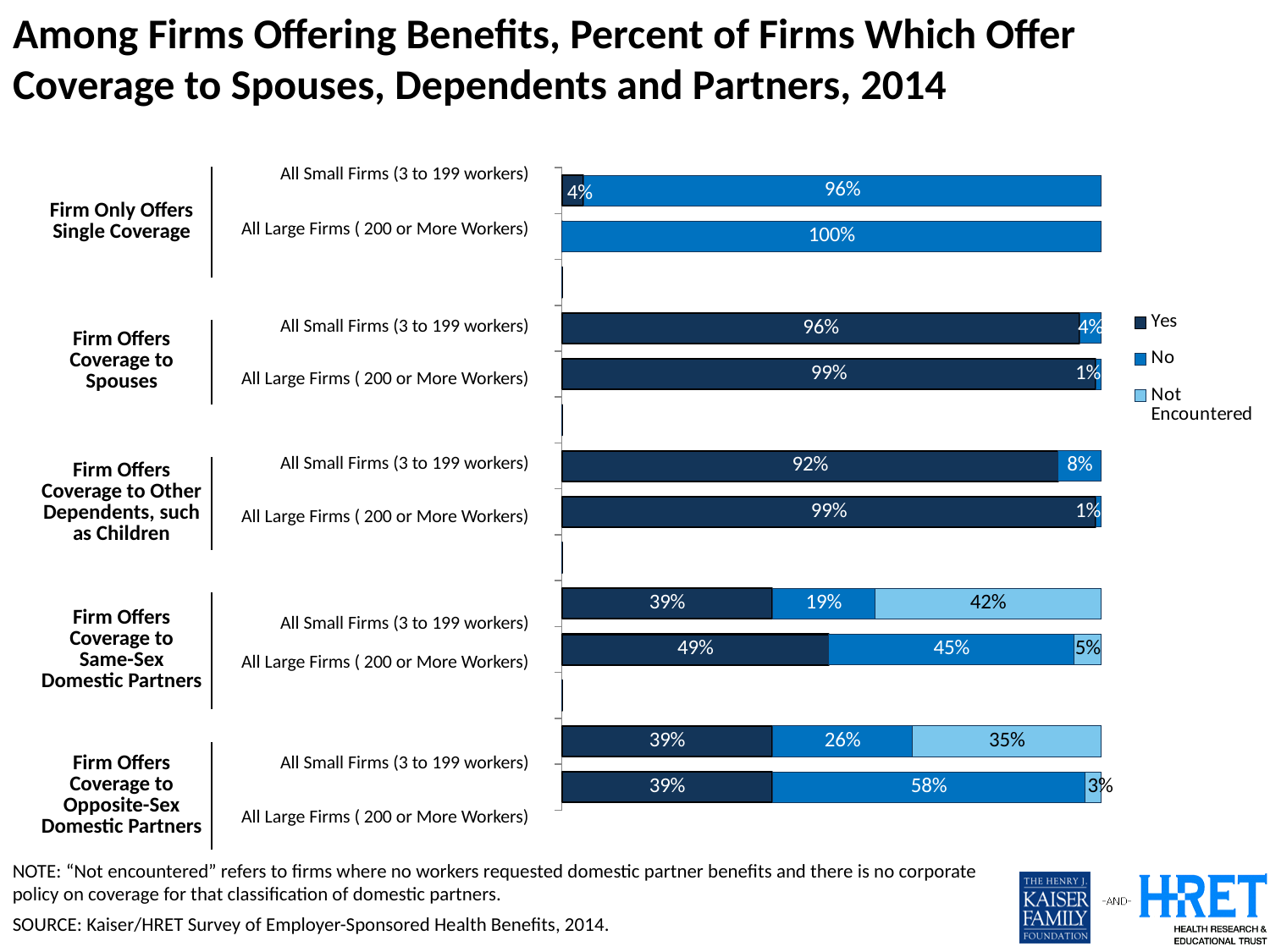
Which firm size has the higher "Not Encountered" share for coverage to opposite-sex domestic partners? All Small Firms (3 to 199 workers) What is the difference between the "Yes" percentages for large firms and small firms for coverage to other dependents, such as children? 7% How many series does the legend list? 3 What are the three legend entries on the chart? Yes, No, Not Encountered Which is larger for coverage to same-sex domestic partners: the "Yes" share for small firms or the "Yes" share for large firms? Large firms What percent of all small firms (3 to 199 workers) fall under "Not Encountered" for coverage to same-sex domestic partners? 42% What percent of all large firms (200 or more workers) answered "No" to only offering single coverage? 100% What kind of chart is shown on the slide? Bar chart What is the total of the stacked bar for all small firms (3 to 199 workers) for coverage to opposite-sex domestic partners? 100% What percent of all small firms (3 to 199 workers) answered "Yes" to offering coverage to spouses? 96% What percent of all large firms (200 or more workers) answered "No" to offering coverage to opposite-sex domestic partners? 58% What percent of all small firms (3 to 199 workers) answered "No" to offering coverage to other dependents, such as children? 8%